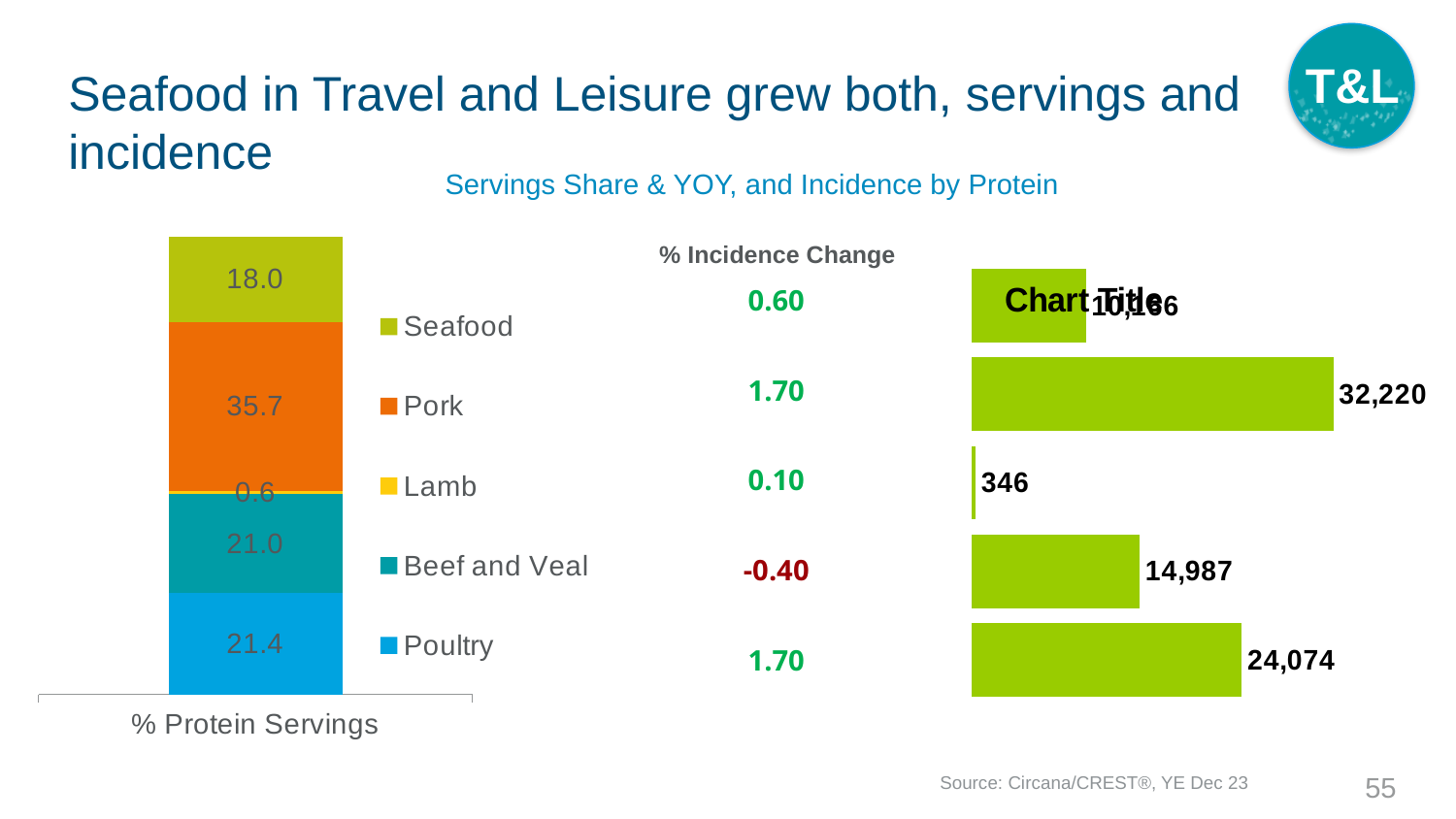
In the % Protein Servings stacked bar chart, what is the difference between the Pork and Seafood values? 17.7 In the % Protein Servings stacked bar chart, what is the value for Pork? 35.7 In the % Protein Servings stacked bar chart, which is larger, Poultry or Beef and Veal? Poultry In the bar chart on the right side of the slide, what is the value of the longest bar? 32,220 In the % Protein Servings stacked bar chart, what is the value for Lamb? 0.6 In the bar chart on the right side of the slide, what is the value of the shortest bar? 346 In the % Protein Servings stacked bar chart, what is the value for Seafood? 18.0 In the % Protein Servings stacked bar chart, which protein has the smallest share? Lamb How many series does the legend of the % Protein Servings chart list? 5 In the % Protein Servings stacked bar chart, what is the value for Poultry? 21.4 What type of chart is the chart on the right side of the slide? Bar chart In the % Protein Servings stacked bar chart, which protein has the largest share? Pork